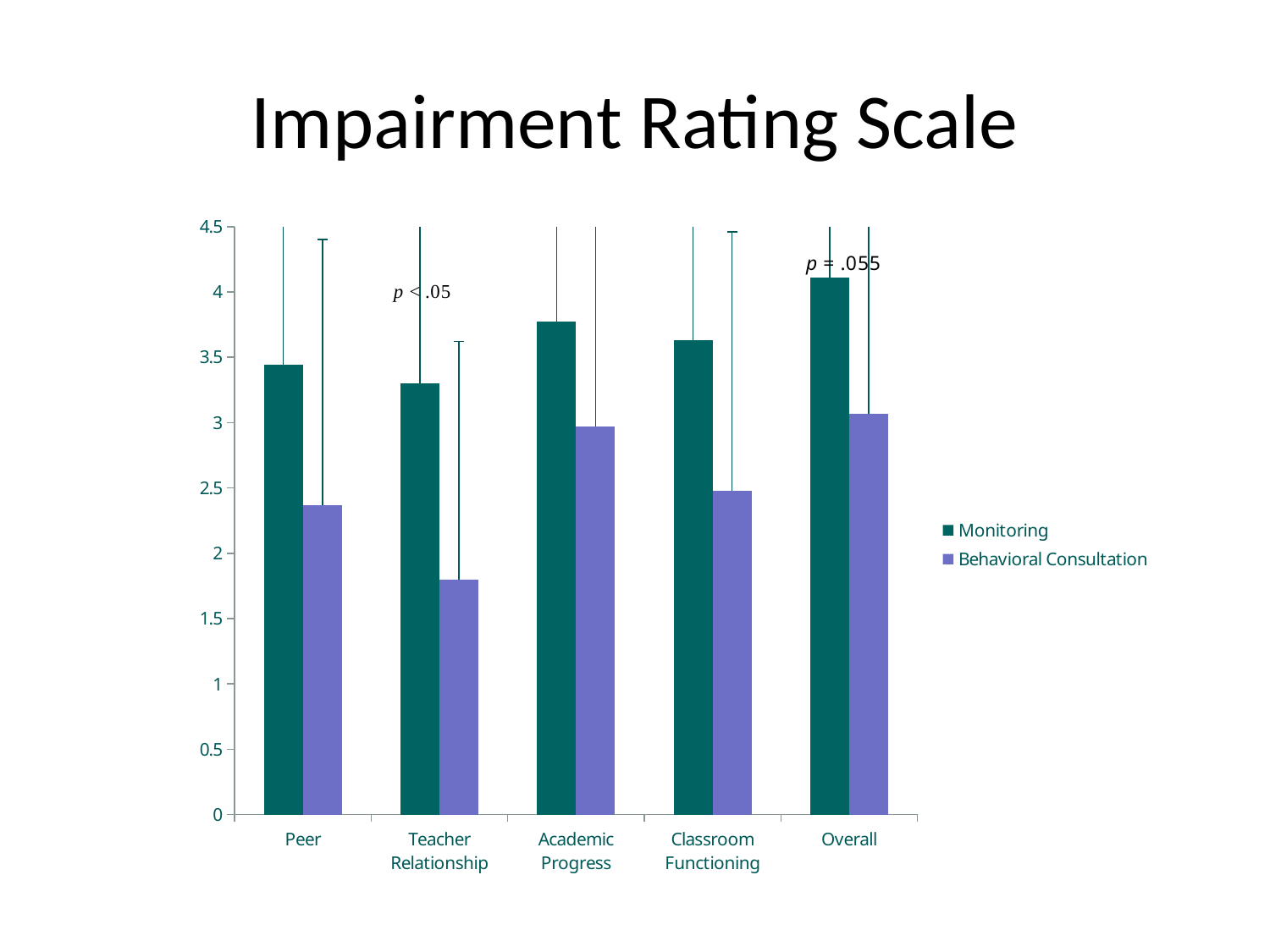
Which p-value annotation is shown above the Overall category? p = .055 What kind of chart is shown on the slide? bar chart Which category has the lowest Behavioral Consultation value? Teacher Relationship Which category has the highest Monitoring value? Overall How many categories are shown on the x axis of the chart? 5 For Classroom Functioning, which series has the larger value, Monitoring or Behavioral Consultation? Monitoring Is the Monitoring value for Overall greater or less than 4? greater Is the Behavioral Consultation value for Teacher Relationship greater or less than 2? less What is the title of the chart? Impairment Rating Scale Is the Behavioral Consultation value for Peer greater or less than 2? greater How many series does the chart's legend list? 2